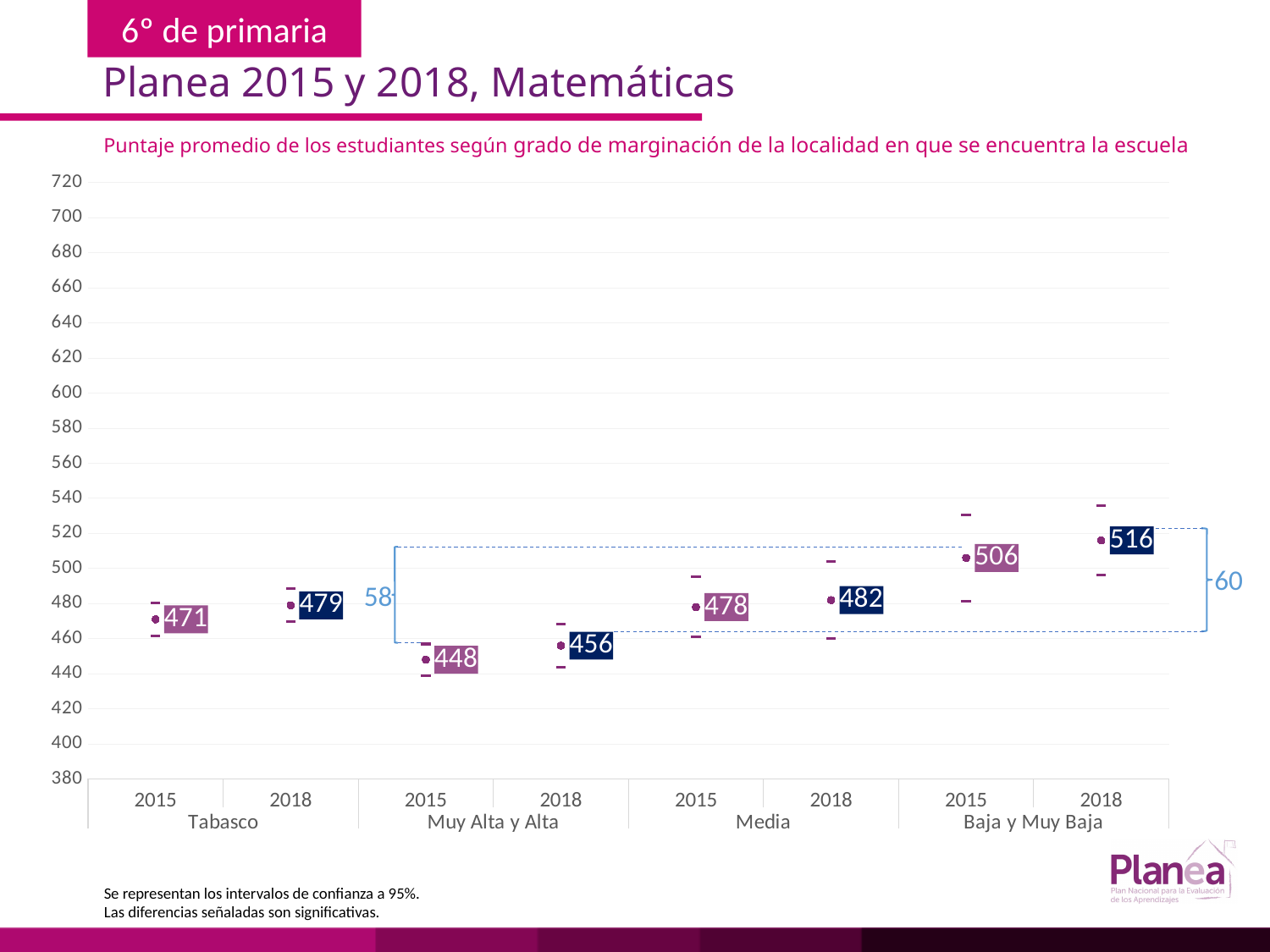
What is the difference between the Baja y Muy Baja 2018 score and the Muy Alta y Alta 2018 score? 60 Which is larger, the Media 2018 score or the Tabasco 2018 score? Media 2018 What is the subtitle of the chart? Puntaje promedio de los estudiantes según grado de marginación de la localidad en que se encuentra la escuela Which group and year has the highest average score? Baja y Muy Baja, 2018 Which group and year has the lowest average score? Muy Alta y Alta, 2015 Is the Baja y Muy Baja 2015 score greater or less than 500? greater What is the average score for Muy Alta y Alta in 2018? 456 What is the average score for Baja y Muy Baja in 2018? 516 What is the average score for Tabasco in 2015? 471 What is the average score for Media in 2015? 478 By how much did the Tabasco average score change from 2015 to 2018? 8